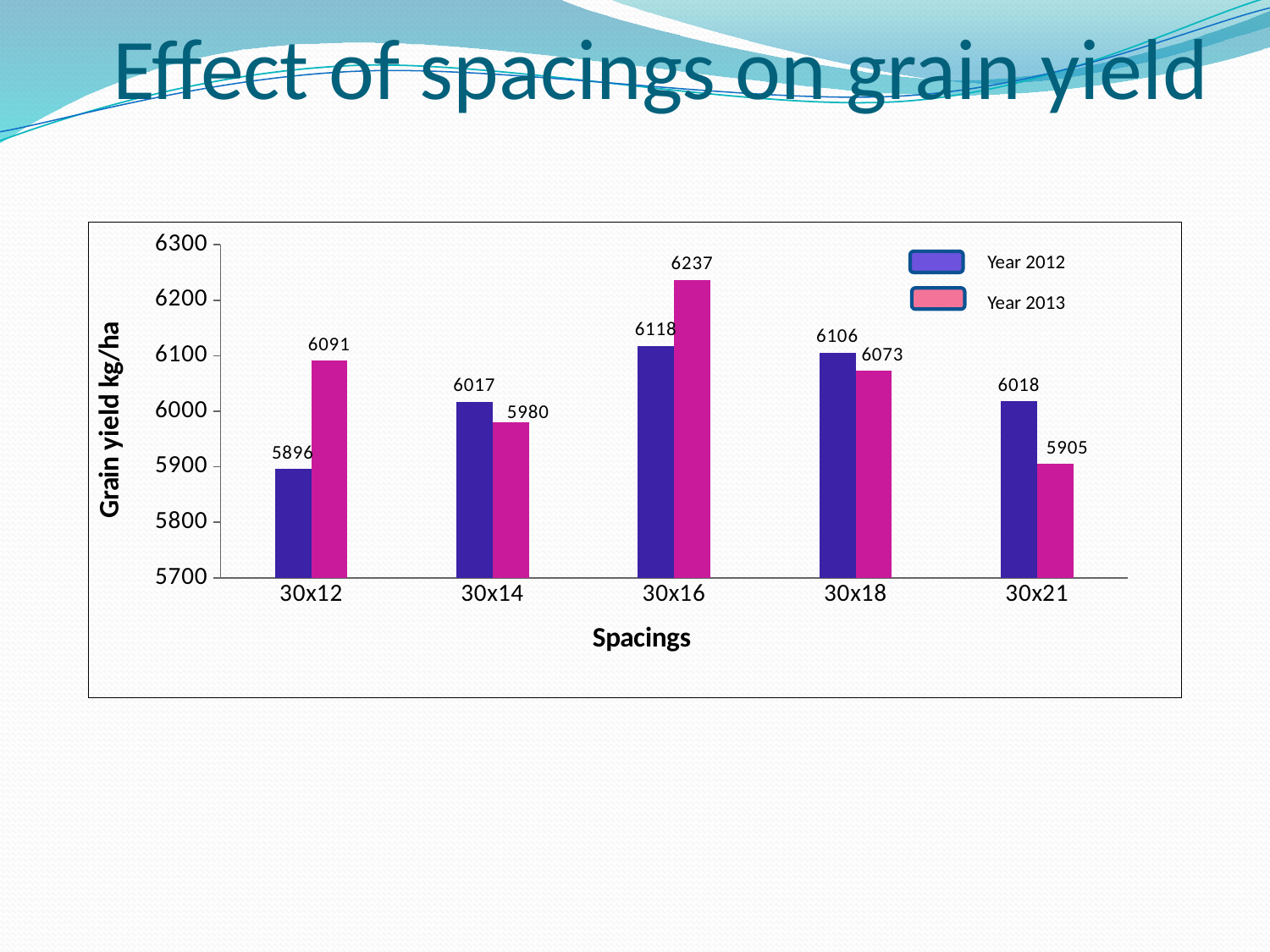
What is the label of the y axis? Grain yield kg/ha Which spacing has the highest grain yield for Year 2013? 30x16 How many series does the legend list? 2 What is the grain yield for Year 2012 at spacing 30x16? 6118 What is the grain yield for Year 2013 at spacing 30x21? 5905 Is the Year 2013 grain yield at spacing 30x14 greater or less than 6000? less Which spacing has the lowest grain yield for Year 2012? 30x12 What is the difference between the Year 2013 and Year 2012 grain yields at spacing 30x12? 195 How many spacings are shown on the x axis? 5 At spacing 30x18, which year has the larger grain yield, Year 2012 or Year 2013? Year 2012 What is the grain yield for Year 2013 at spacing 30x12? 6091 What kind of chart is shown on the slide? bar chart